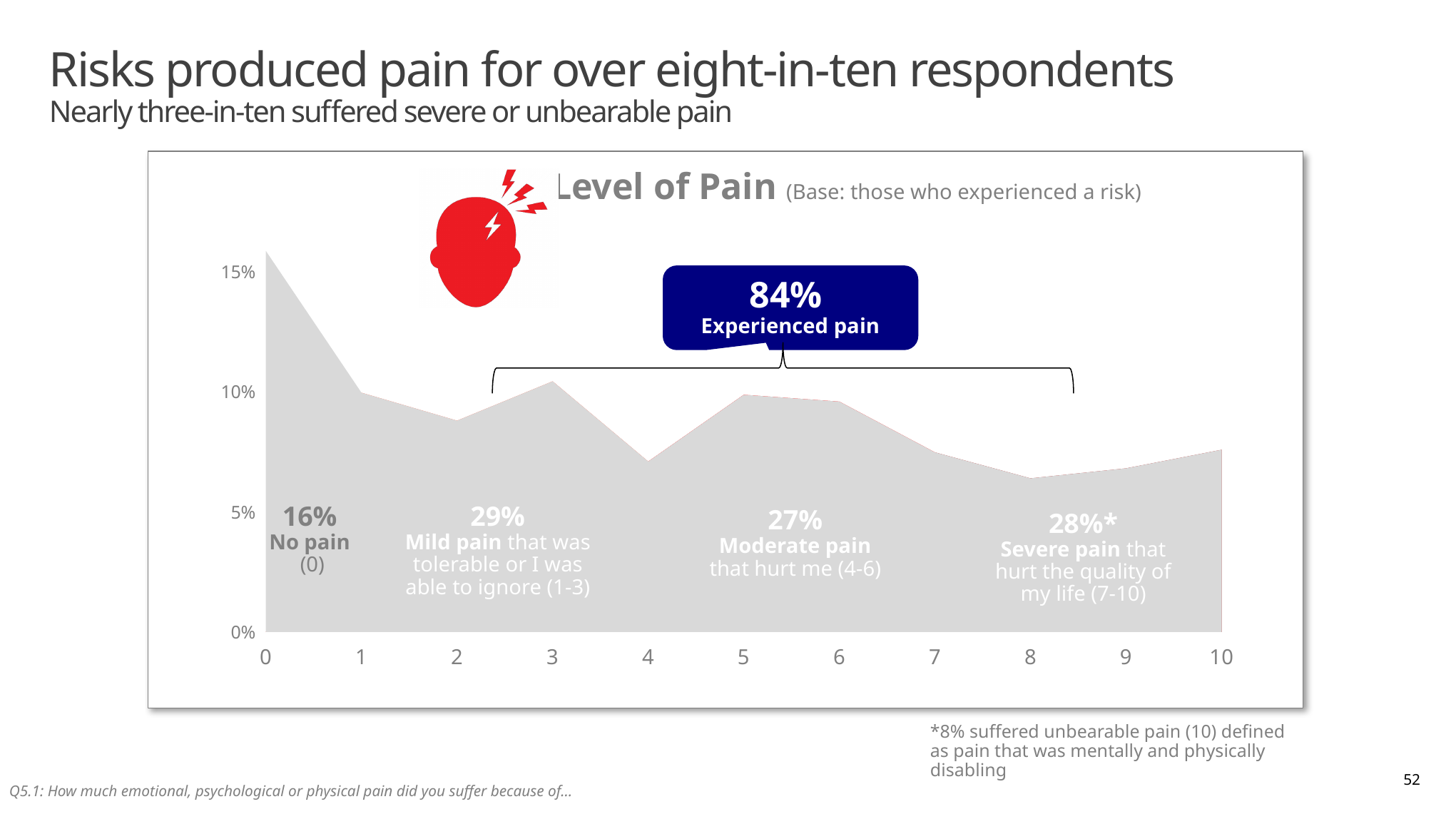
What kind of chart is shown on the slide? Area chart What is the difference between the mild pain share and the moderate pain share? 2% How many pain levels are plotted along the x axis? 11 What percentage of respondents experienced pain, according to the callout? 84% Which is larger, the share reporting mild pain (1-3) or moderate pain (4-6)? Mild pain (1-3) What percentage of respondents reported mild pain (1-3)? 29% What percentage of respondents reported no pain (0)? 16% Which pain level on the x axis has the highest value? 0 What percentage of respondents reported severe pain (7-10)? 28% What percentage of respondents suffered unbearable pain (10)? 8% What percentage of respondents reported moderate pain (4-6)? 27% Is the value for pain level 4 greater or less than 10%? less